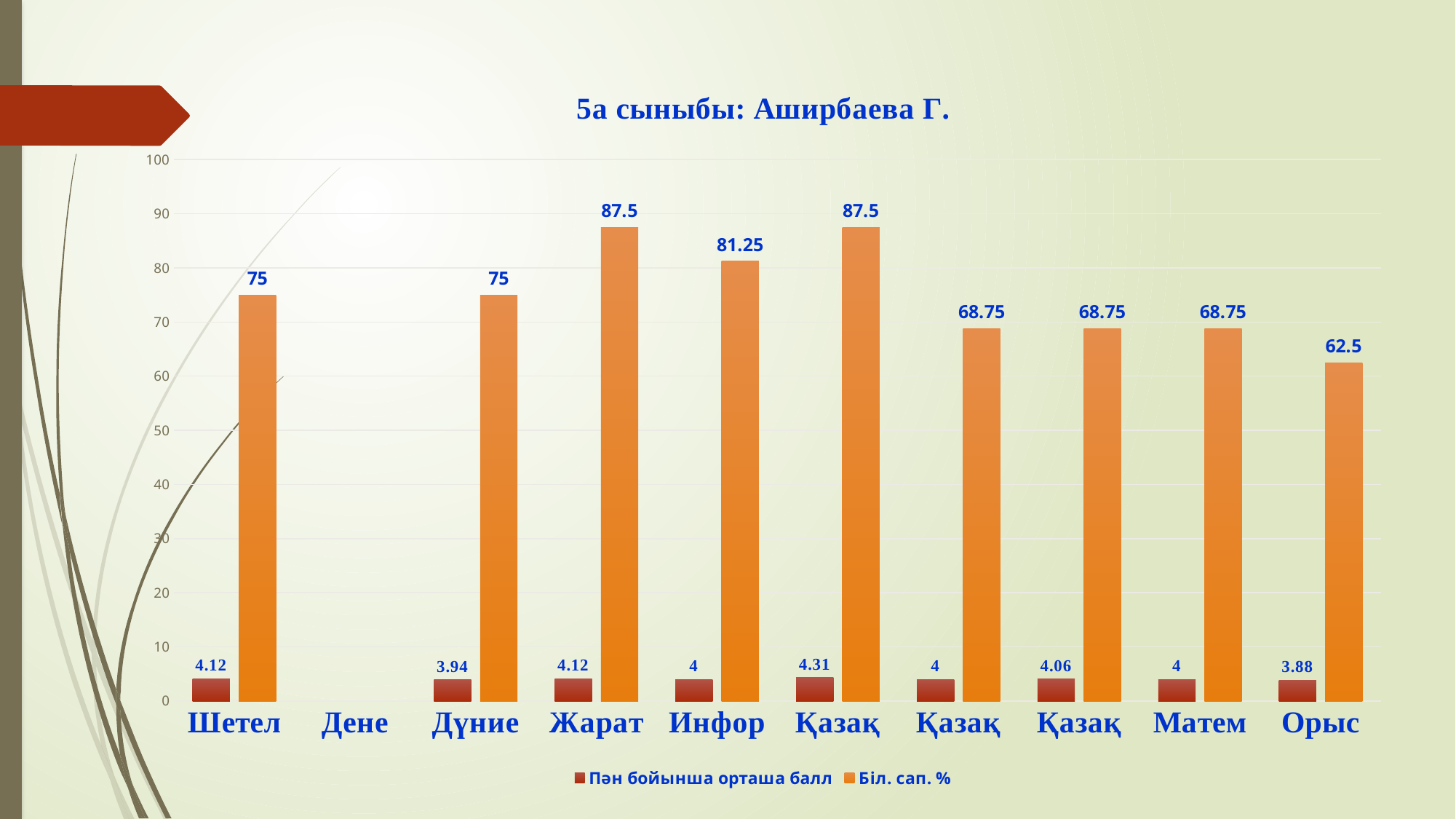
Which category has the lowest value of Біл. сап. %? Орыс Is the Біл. сап. % value for Матем greater or less than 60? greater What is the value of Пән бойынша орташа балл for Дүние? 3.94 How many categories are shown on the x axis? 10 What is the value of Біл. сап. % for Инфор? 81.25 How many series does the legend list? 2 Which category has the lowest value of Пән бойынша орташа балл? Орыс What is the value of Пән бойынша орташа балл for Орыс? 3.88 Which has a higher Біл. сап. % value, Инфор or Дүние? Инфор What type of chart is shown on the slide? Bar chart What is the value of Біл. сап. % for Жарат? 87.5 What is the difference between the Біл. сап. % values for Жарат and Орыс? 25